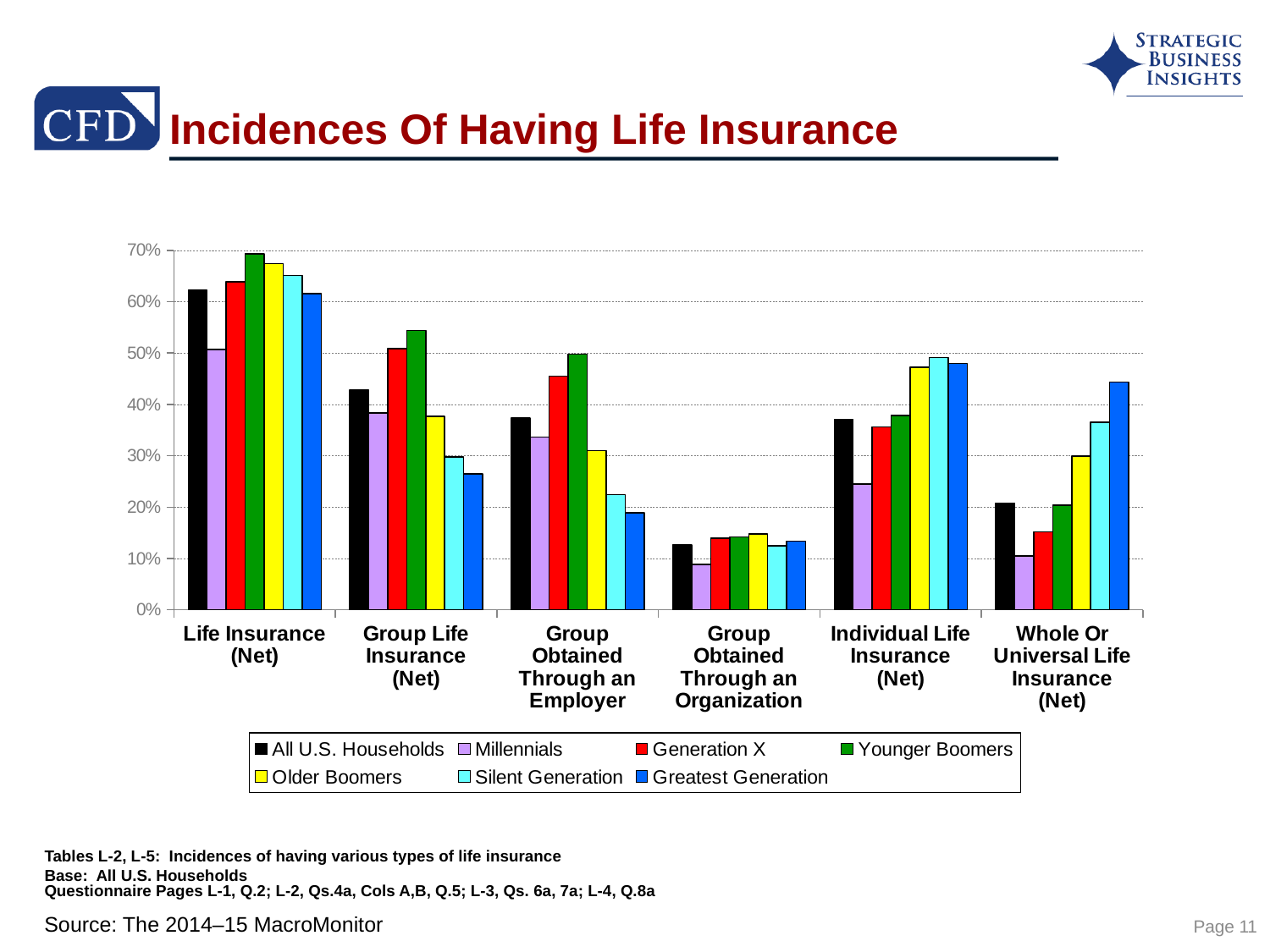
Is the value for Younger Boomers in Group Life Insurance (Net) greater or less than 50%? greater In the Individual Life Insurance (Net) category, which generation has the lowest value? Millennials In the Whole Or Universal Life Insurance (Net) category, which generation has the highest value? Greatest Generation In the Whole Or Universal Life Insurance (Net) category, which is larger: Silent Generation or Older Boomers? Silent Generation Is the value for Greatest Generation in Group Life Insurance (Net) greater or less than 30%? less Is the value for Millennials in Life Insurance (Net) greater or less than 60%? less In the Group Obtained Through an Employer category, which generation has the lowest value? Greatest Generation In the Group Obtained Through an Employer category, which is larger: Generation X or Older Boomers? Generation X What kind of chart is shown on the slide? bar chart How many insurance categories are shown along the x axis? 6 How many series does the legend list? 7 What colour represents Generation X in the legend? red